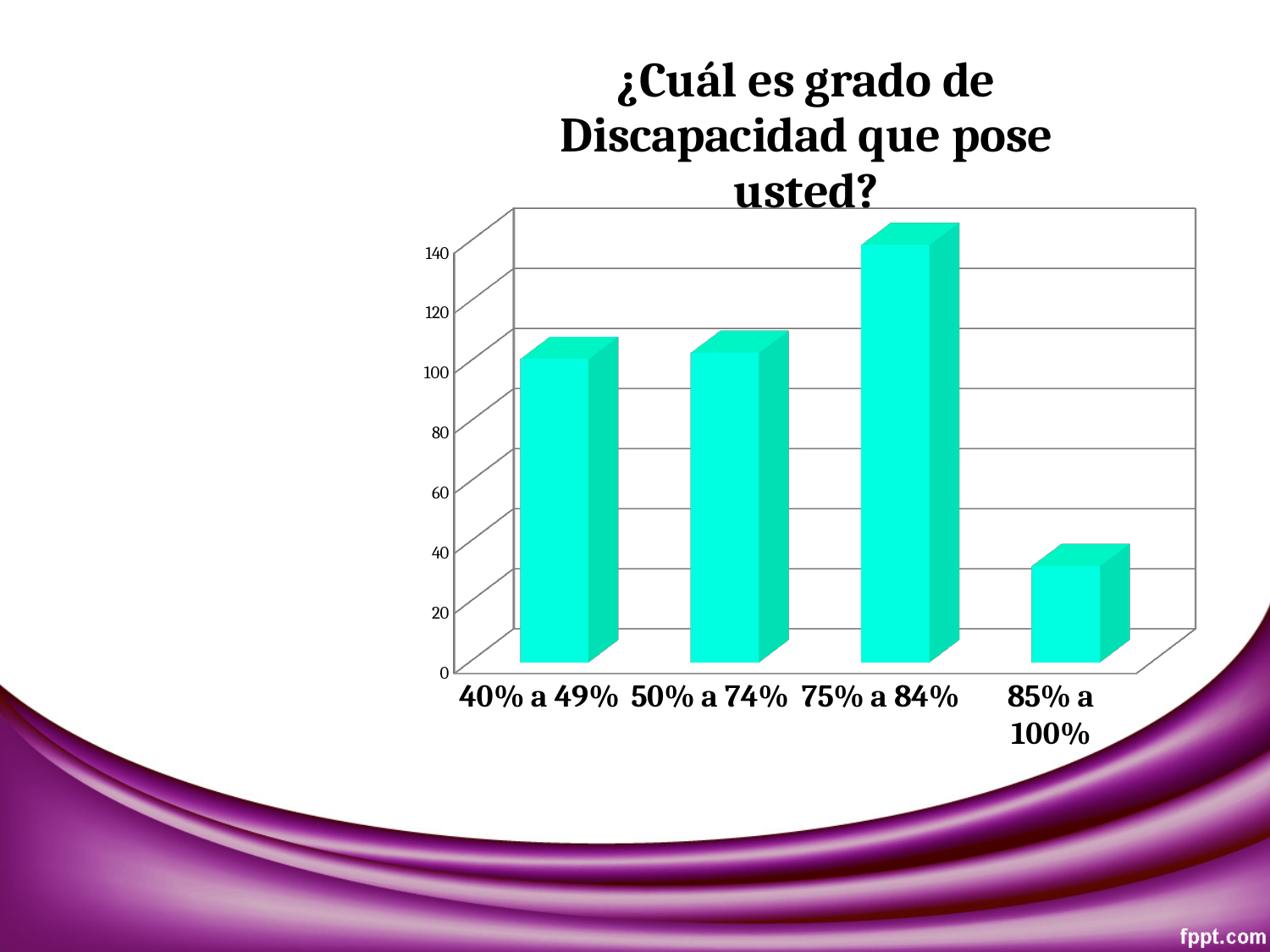
How many categories are shown on the x axis of the chart? 4 Is the value for 40% a 49% greater or less than 80? greater What kind of chart is shown on the slide? bar chart What is the title of the chart? ¿Cuál es grado de Discapacidad que pose usted? Is the value for 50% a 74% greater or less than 80? greater Is the value for 85% a 100% greater or less than 40? less Which is larger, the value for 40% a 49% or the value for 85% a 100%? 40% a 49% Which is larger, the value for 75% a 84% or the value for 85% a 100%? 75% a 84% Which category has the highest value? 75% a 84% Which category has the lowest value? 85% a 100% Does the value rise or fall from 75% a 84% to 85% a 100%? fall